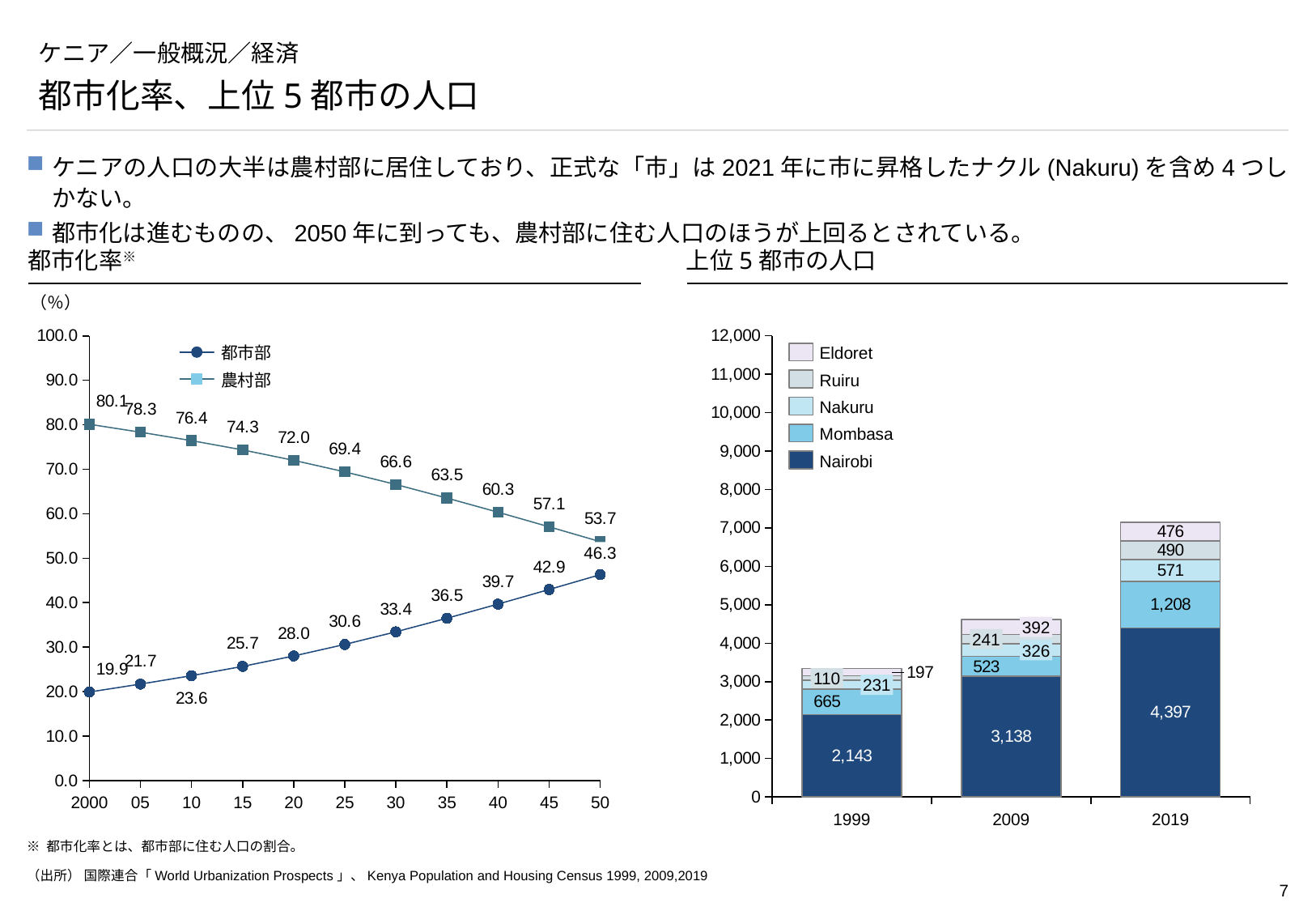
In the 上位5都市の人口 chart on the right, what is the total of the stacked bar for 2019? 7,142 In the 上位5都市の人口 chart on the right, which is larger: Nairobi in 2019 or Nairobi in 2009? Nairobi in 2019 In the 都市化率 chart on the left, what is the 農村部 value for 2000? 80.1 How many series does the legend of the 上位5都市の人口 chart on the right list? 5 In the 都市化率 chart on the left, what is the 都市部 value for 2050? 46.3 In the 上位5都市の人口 chart on the right, what is the value for Nairobi in 2019? 4,397 How many data points does each series in the 都市化率 chart on the left have? 11 In the 都市化率 chart on the left, what is the difference between the 都市部 values for 2050 and 2000? 26.4 In the 都市化率 chart on the left, does the 都市部 series rise or fall from 2000 to 2050? Rise What kind of chart is the 上位5都市の人口 chart on the right? Stacked bar chart In the 上位5都市の人口 chart on the right, what is the value for Mombasa in 2009? 523 In the 都市化率 chart on the left, in which year is the 農村部 value highest? 2000